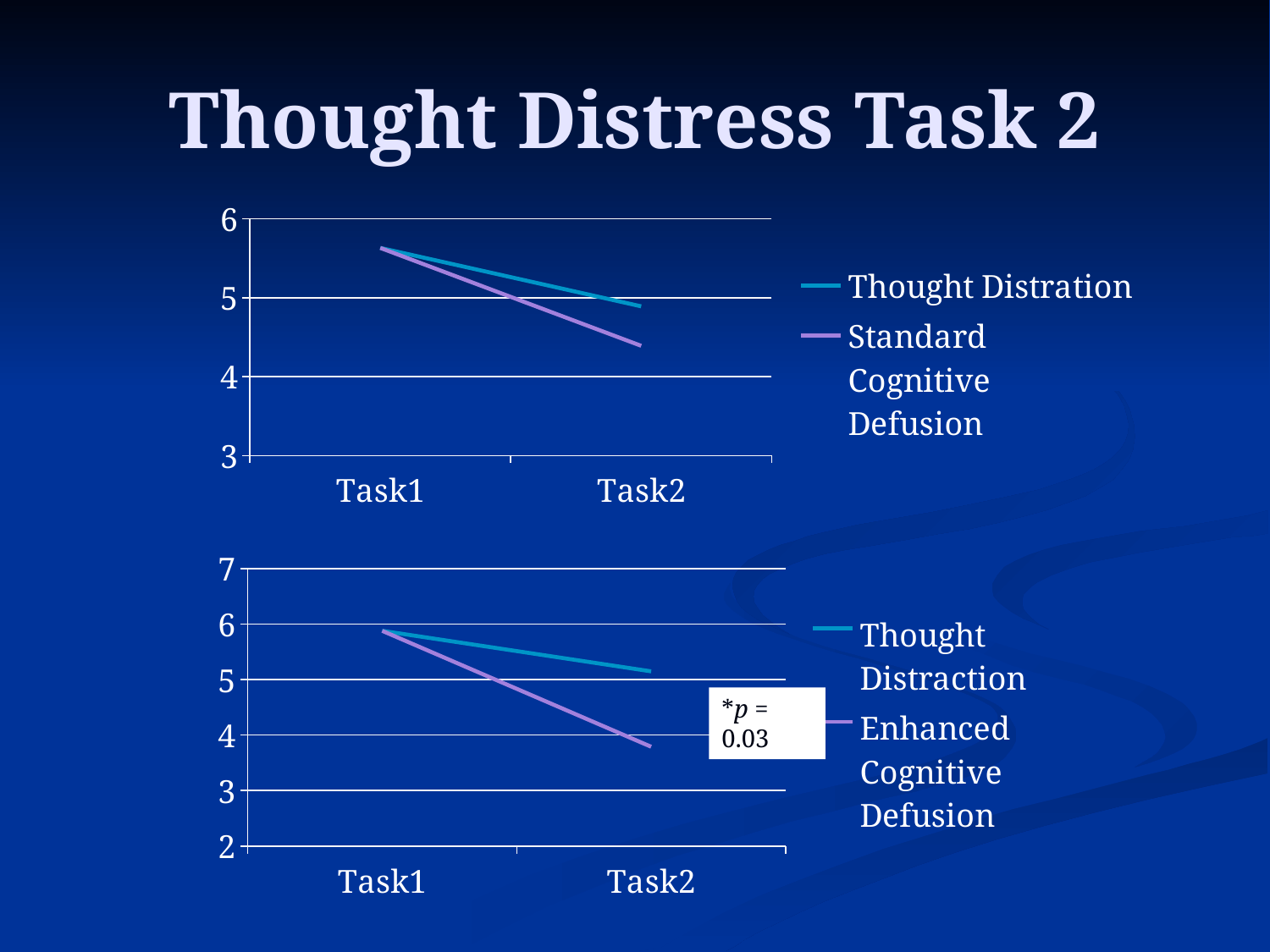
In the top chart, is the value for Thought Distration at Task1 greater or less than 5? greater In the top chart, how many series does the legend list? 2 In the top chart, is the value for Standard Cognitive Defusion at Task2 greater or less than 5? less In the bottom chart, is the value for Enhanced Cognitive Defusion at Task2 greater or less than 4? less In the top chart, at Task2, which series has the higher value: Thought Distration or Standard Cognitive Defusion? Thought Distration In the top chart, does the Standard Cognitive Defusion line rise or fall from Task1 to Task2? fall What kind of chart is the bottom chart on the slide? line chart In the bottom chart, does the Thought Distraction line rise or fall from Task1 to Task2? fall In the bottom chart, how many categories are shown on the x axis? 2 What p-value is annotated on the bottom chart? *p = 0.03 What kind of chart is the top chart on the slide? line chart In the bottom chart, at Task2, which series has the higher value: Thought Distraction or Enhanced Cognitive Defusion? Thought Distraction